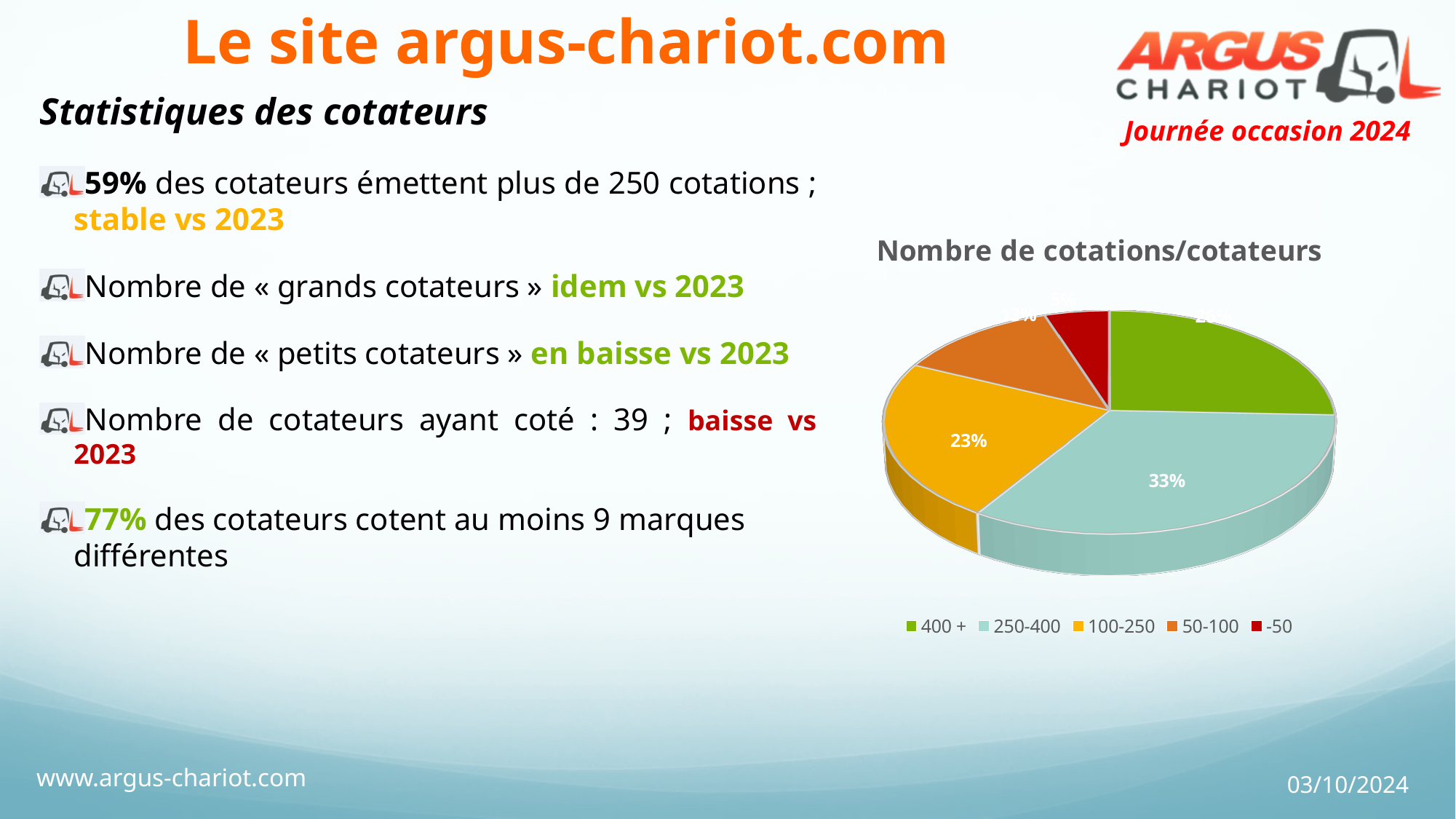
What colour is the 100-250 slice of the pie? yellow Which category has the largest slice of the pie? 250-400 What kind of chart is shown on the slide? pie chart What is the difference in percentage points between the 250-400 slice and the 100-250 slice? 10 What is the title of the chart? Nombre de cotations/cotateurs Which slice is larger, 100-250 or 50-100? 100-250 What share of the pie does the 250-400 category represent? 33% Which slice is larger, 250-400 or 100-250? 250-400 Which category has the smallest slice of the pie? -50 Which slice is larger, 400 + or -50? 400 + What share of the pie does the 100-250 category represent? 23% How many categories does the pie chart's legend list? 5